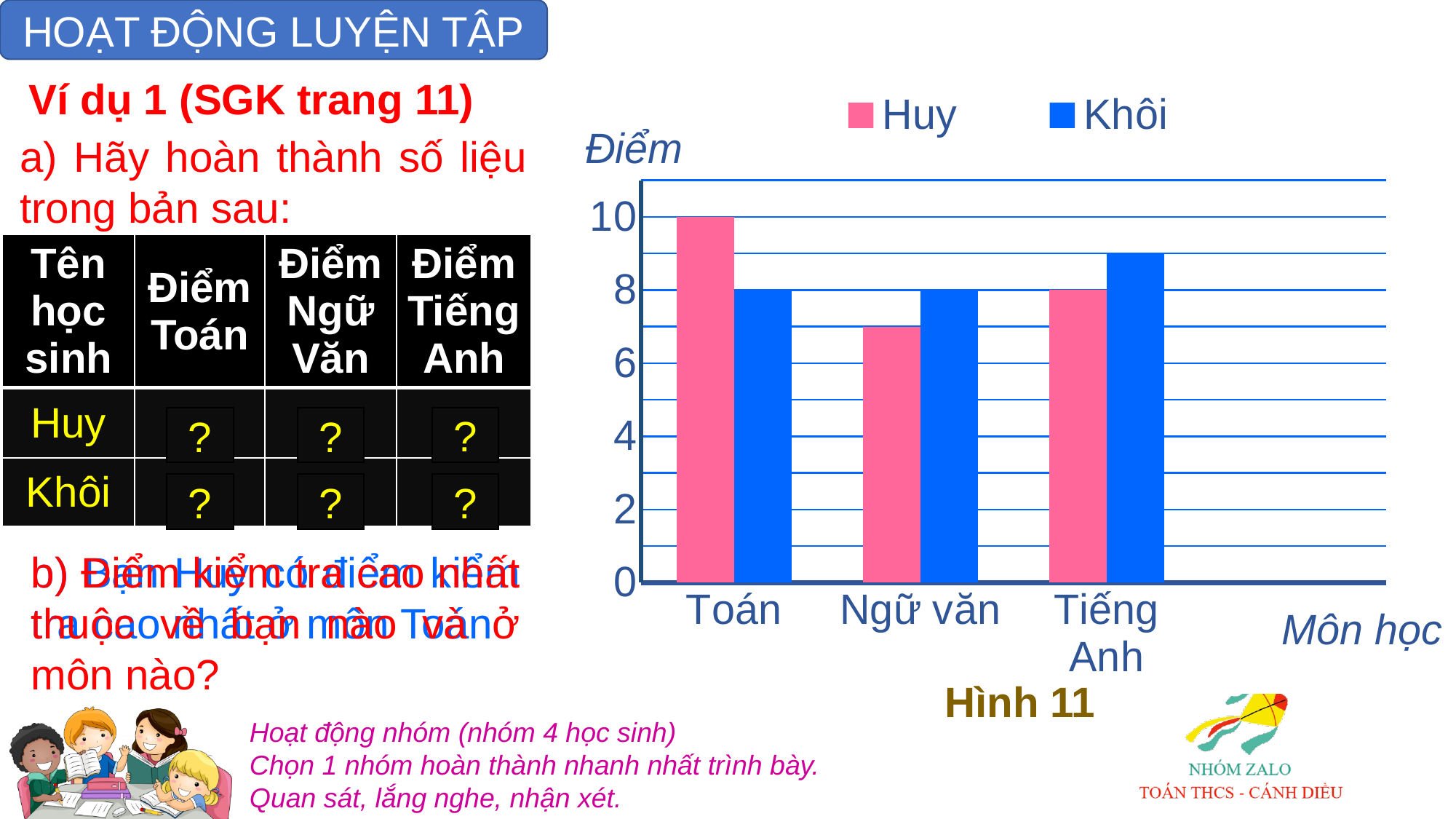
What kind of chart is shown on the slide? bar chart Is Khôi's score in Tiếng Anh greater or less than 8? greater What is Huy's score in Toán? 10 How many series does the legend list? 2 What is the difference between Huy's and Khôi's scores in Toán? 2 What is Khôi's score in Toán? 8 Is Huy's score in Ngữ văn greater or less than 8? less How many subjects (categories) are shown on the x axis? 3 In which subject does Huy have the highest score? Toán What is Khôi's score in Ngữ văn? 8 Who has the higher score in Ngữ văn, Huy or Khôi? Khôi What is Huy's score in Tiếng Anh? 8